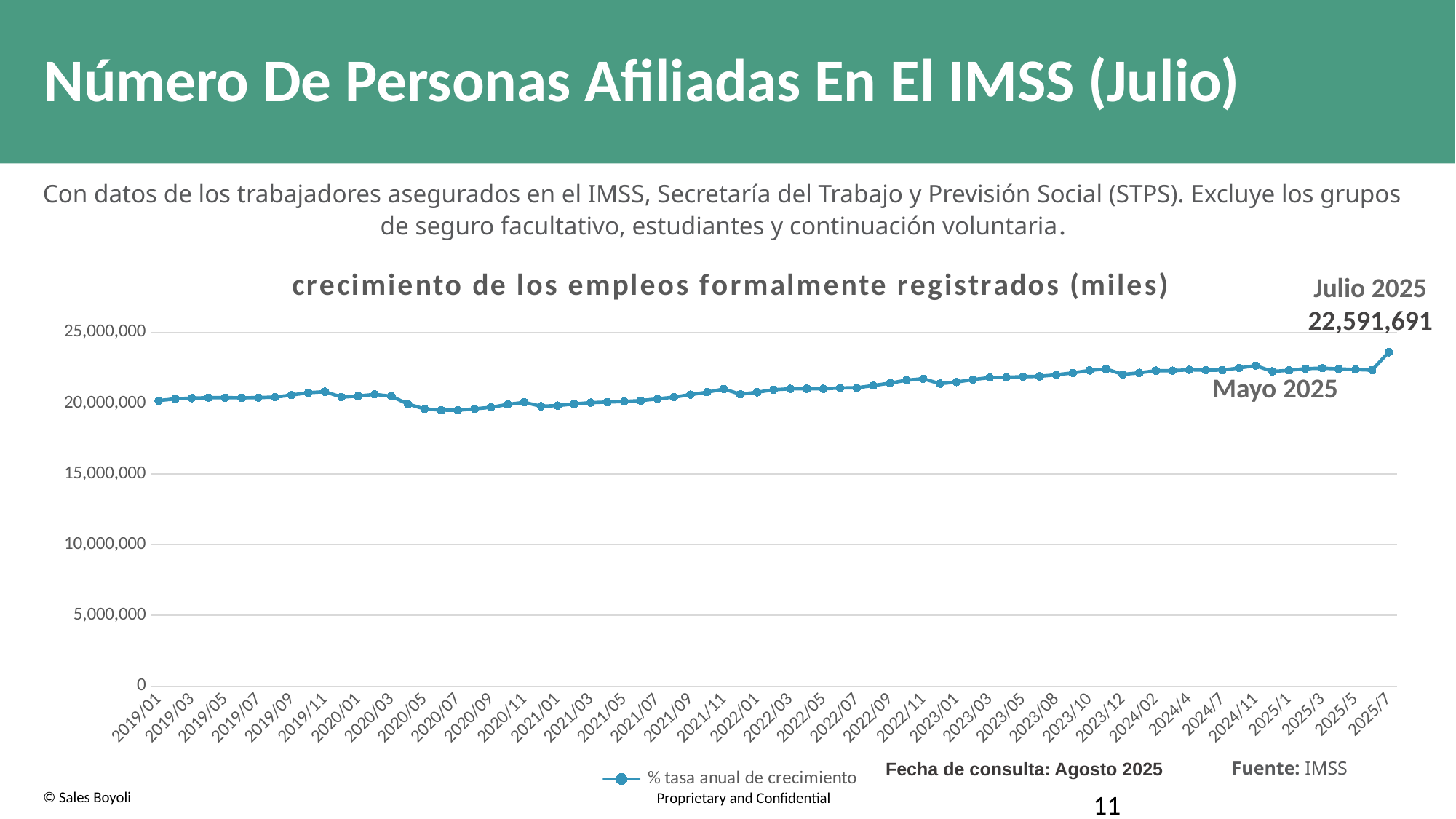
Which point on the chart has the highest value? 2025/7 What value is labelled for Julio 2025 on the chart? 22,591,691 Which is larger, the value for 2019/01 or the value for 2025/7? 2025/7 Is the value for 2020/07 greater or less than 20,000,000? less Overall, do the values rise or fall from 2019/01 to 2025/7? rise What is the title of the chart? crecimiento de los empleos formalmente registrados (miles) What is the name of the series in the chart legend? % tasa anual de crecimiento Is the value for 2025/7 greater or less than 25,000,000? less How many series does the chart legend list? 1 Is the value for 2023/01 greater or less than 20,000,000? greater What kind of chart is shown on the slide? line chart